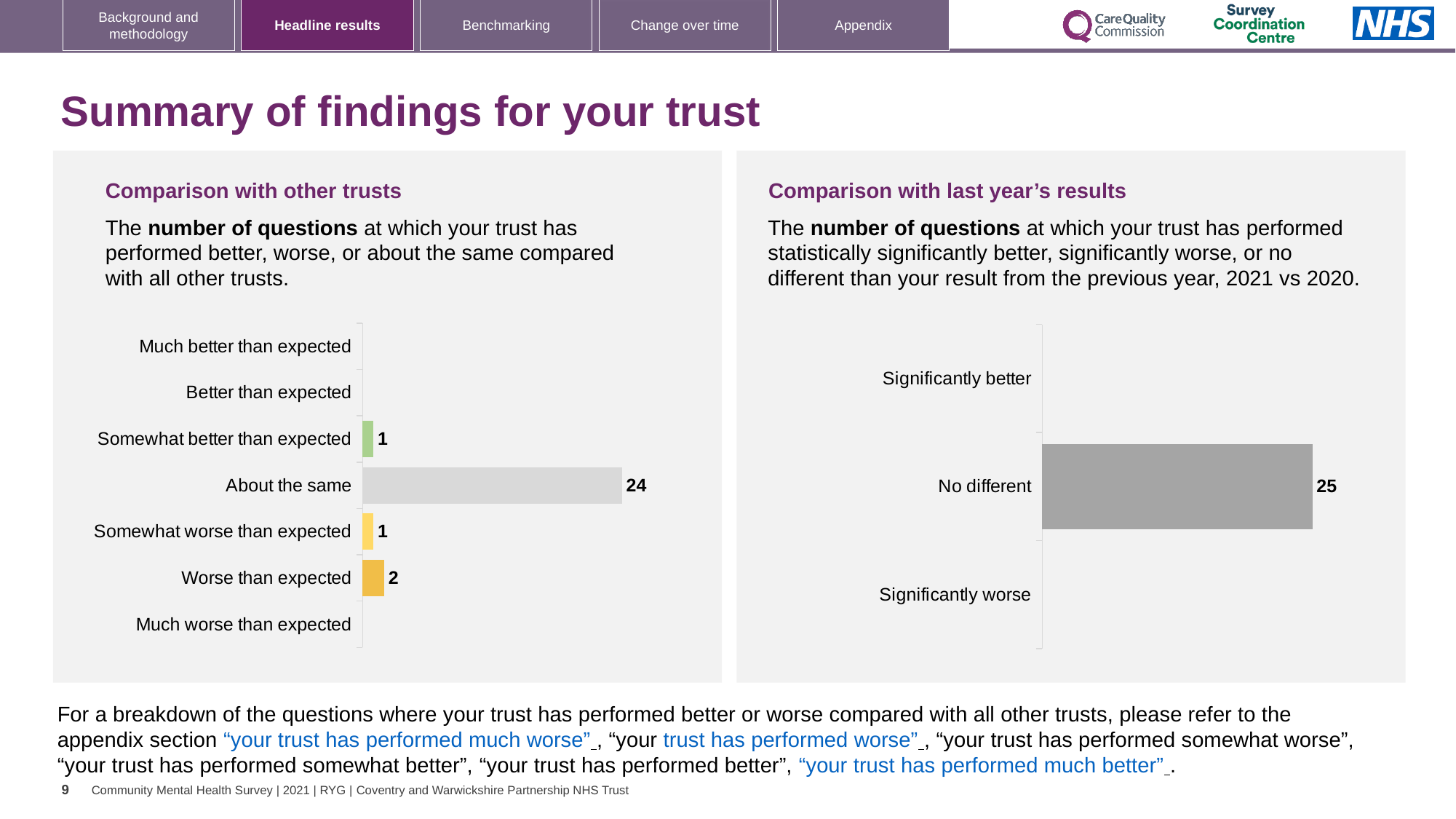
In the 'Comparison with last year's results' chart, which category has the highest value? No different In the 'Comparison with other trusts' chart, what is the value for 'Somewhat better than expected'? 1 How many categories are listed on the 'Comparison with last year's results' chart? 3 In the 'Comparison with other trusts' chart, how many questions are 'About the same'? 24 What type of chart is used in the 'Comparison with other trusts' panel? Bar chart In the 'Comparison with other trusts' chart, what is the value for 'Worse than expected'? 2 In the 'Comparison with other trusts' chart, which is larger: 'Worse than expected' or 'Somewhat worse than expected'? Worse than expected In the 'Comparison with other trusts' chart, which category has the highest value? About the same How many categories are listed on the 'Comparison with other trusts' chart? 7 In the 'Comparison with last year's results' chart, what is the value for 'No different'? 25 In the 'Comparison with other trusts' chart, what is the difference between 'About the same' and 'Worse than expected'? 22 In the 'Comparison with other trusts' chart, what colour is the 'About the same' bar? Grey